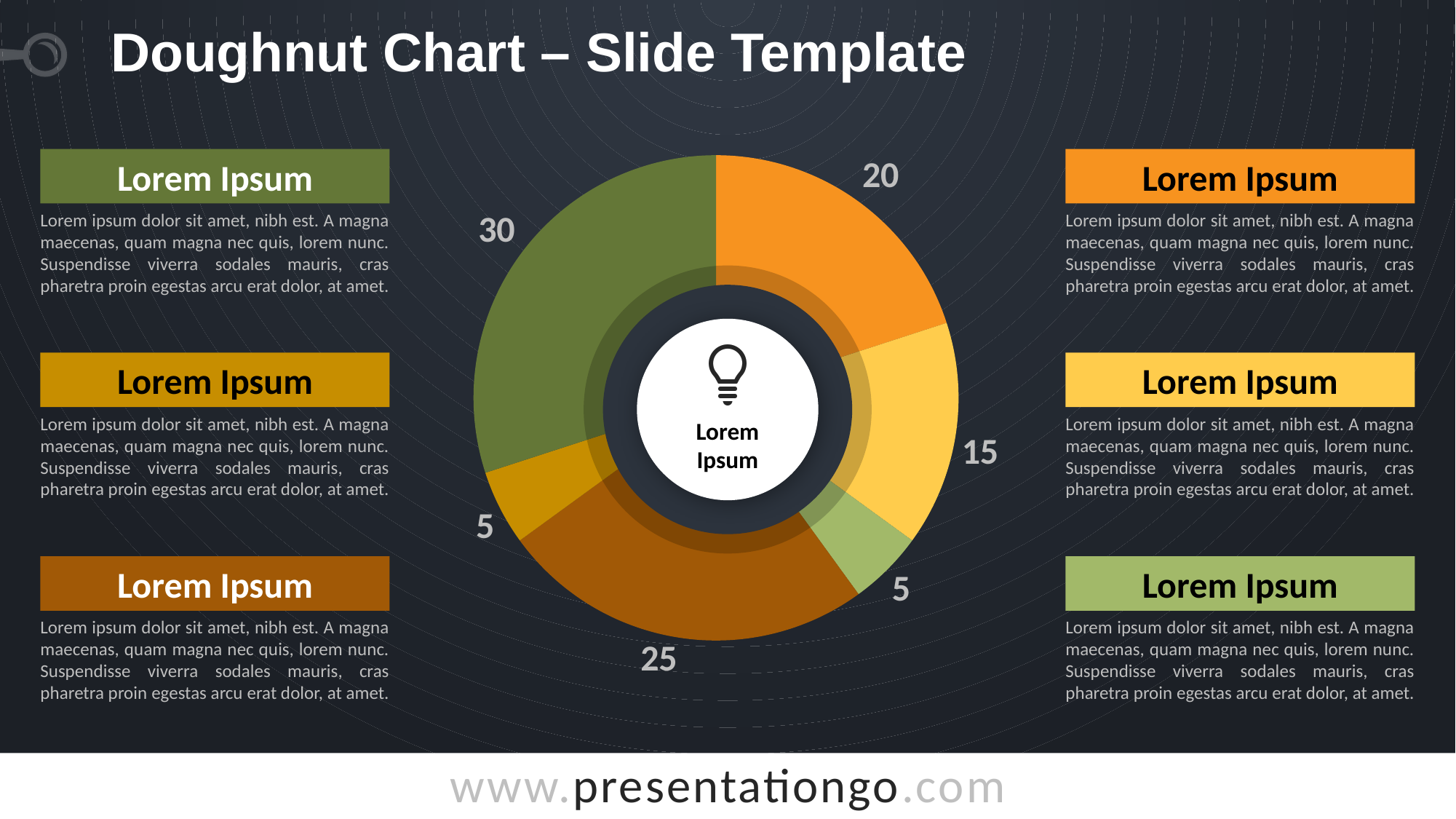
What is the value of the orange slice of the doughnut chart? 20 What kind of chart is shown on the slide? Doughnut chart What is the value of the olive green slice of the doughnut chart? 30 Which is larger, the orange slice or the yellow slice? The orange slice What is the value of the brown slice at the bottom of the doughnut chart? 25 What is the value of the yellow slice on the right side of the doughnut chart? 15 What text appears in the centre of the doughnut chart? Lorem Ipsum What is the total of all the slice values in the doughnut chart? 100 How many slices does the doughnut chart have? 6 What is the difference between the largest slice (30) and the brown slice (25)? 5 What is the value of the largest slice in the doughnut chart? 30 What is the smallest value shown on the doughnut chart? 5